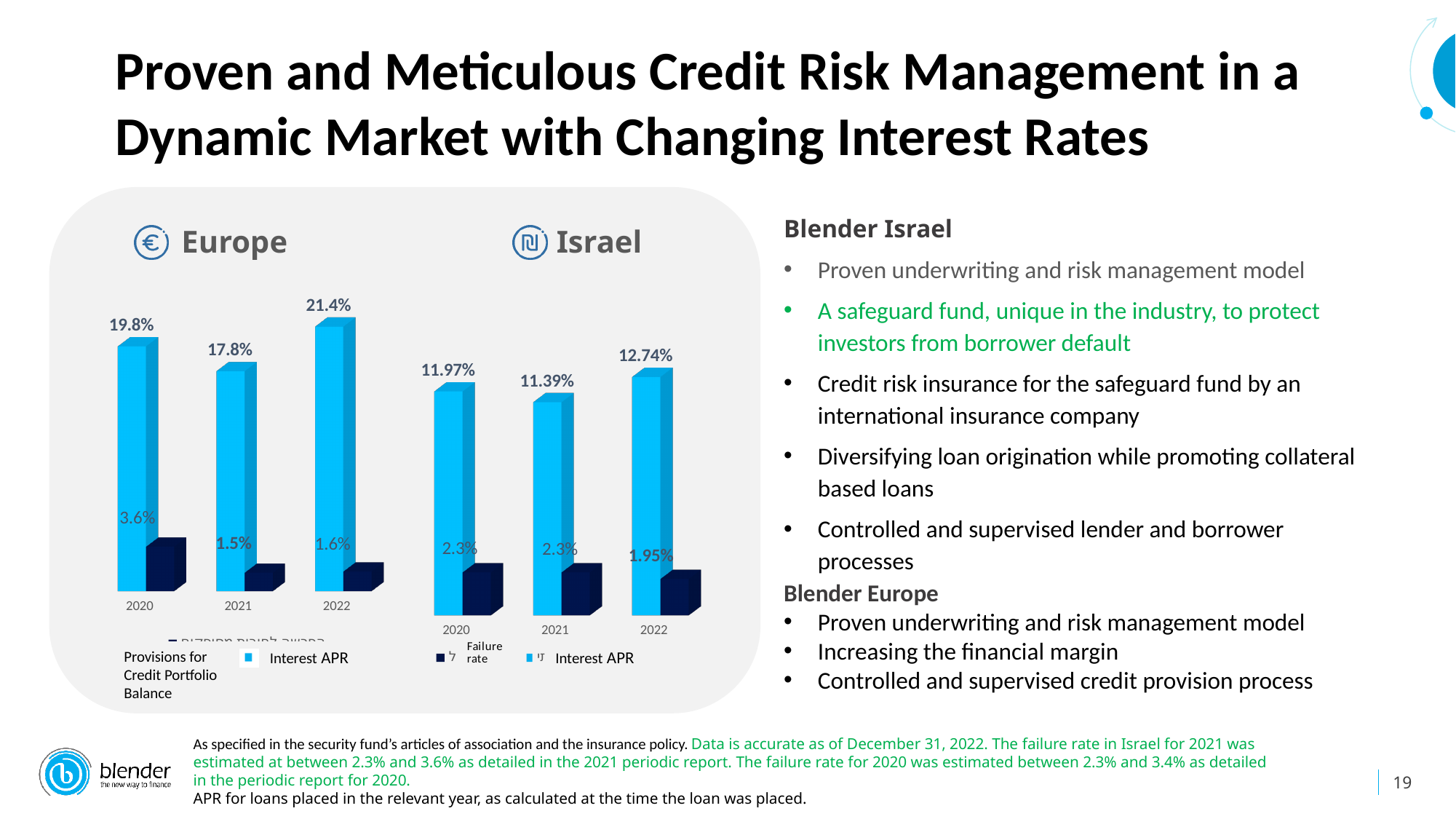
In the Europe chart, which is larger: the Provisions for Credit Portfolio Balance in 2020 or in 2021? 2020 In the Israel chart, what is the difference between the Interest APR for 2022 and 2020? 0.77% In the Israel chart, what is the Interest APR for 2021? 11.39% In the Europe chart, what is the difference between the Interest APR for 2022 and 2021? 3.6% In the Europe chart, what is the Provisions for Credit Portfolio Balance value for 2020? 3.6% How many series does the legend of the Israel chart list? 2 In the Israel chart, which year has the lowest Interest APR? 2021 How many years are shown on the x axis of the Israel chart? 3 What type of chart is the Europe chart? Bar chart In the Europe chart, which year has the highest Interest APR? 2022 In the Europe chart, what is the Interest APR for 2022? 21.4% In the Israel chart, what is the Failure rate for 2022? 1.95%